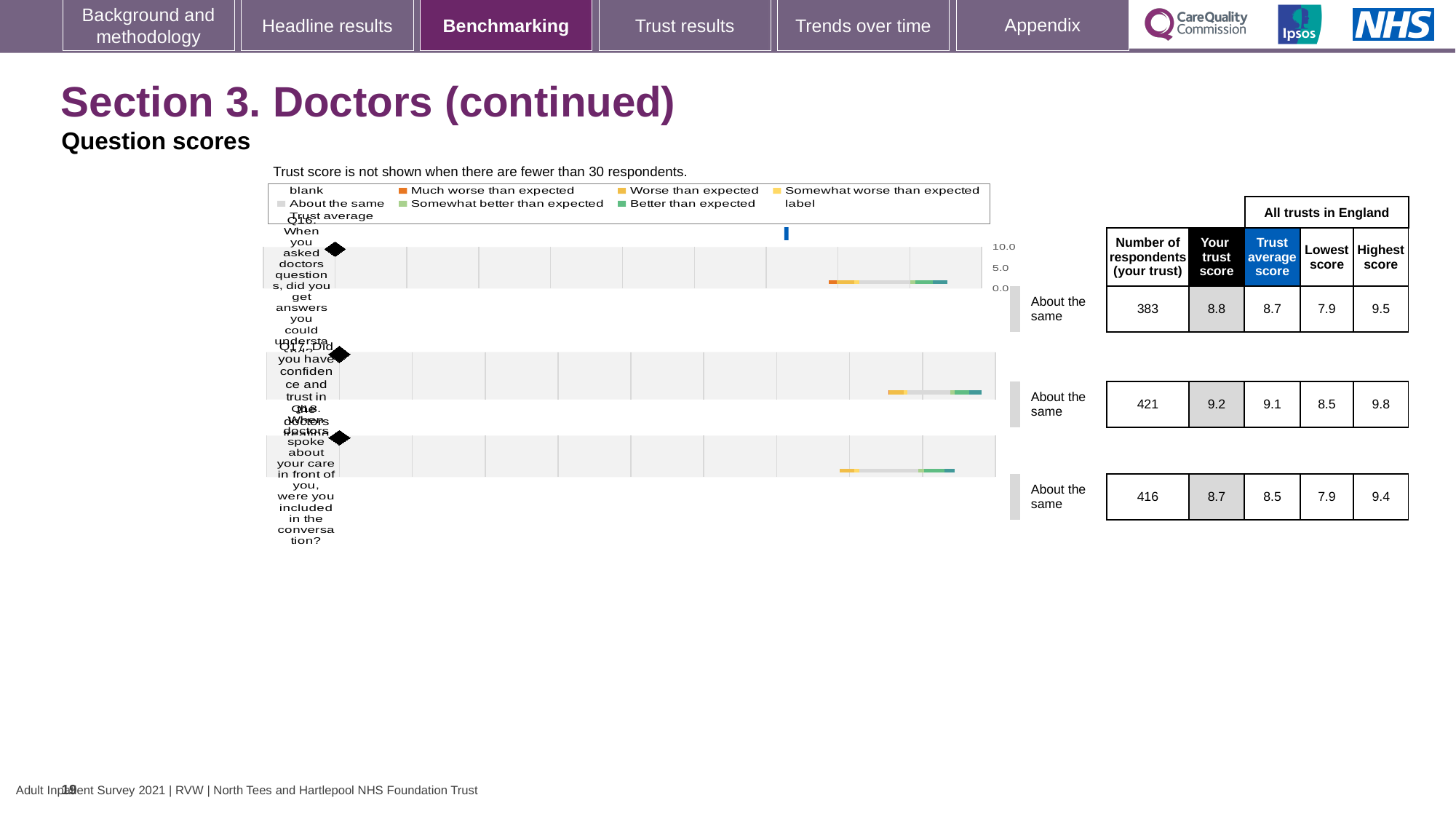
What is the difference between 'Your trust score' and the trust average score for Q16? 0.1 Which question has more respondents from your trust, Q17 or Q18? Q17 How many respondents (your trust) are shown for Q16 (getting answers you could understand from doctors)? 383 What is the highest score across all trusts in England for Q17? 9.8 What is the lowest score across all trusts in England for Q16? 7.9 What is the trust average score for Q18 (being included in the conversation when doctors spoke about your care)? 8.5 What benchmark category is shown for Q18? About the same Which question has the lowest 'Your trust score'? Q18 What is the 'Your trust score' for Q17 (confidence and trust in the doctors treating you)? 9.2 How many questions are plotted on the chart? 3 What type of chart is used to show the question scores? Bar chart Which question has the highest 'Your trust score'? Q17